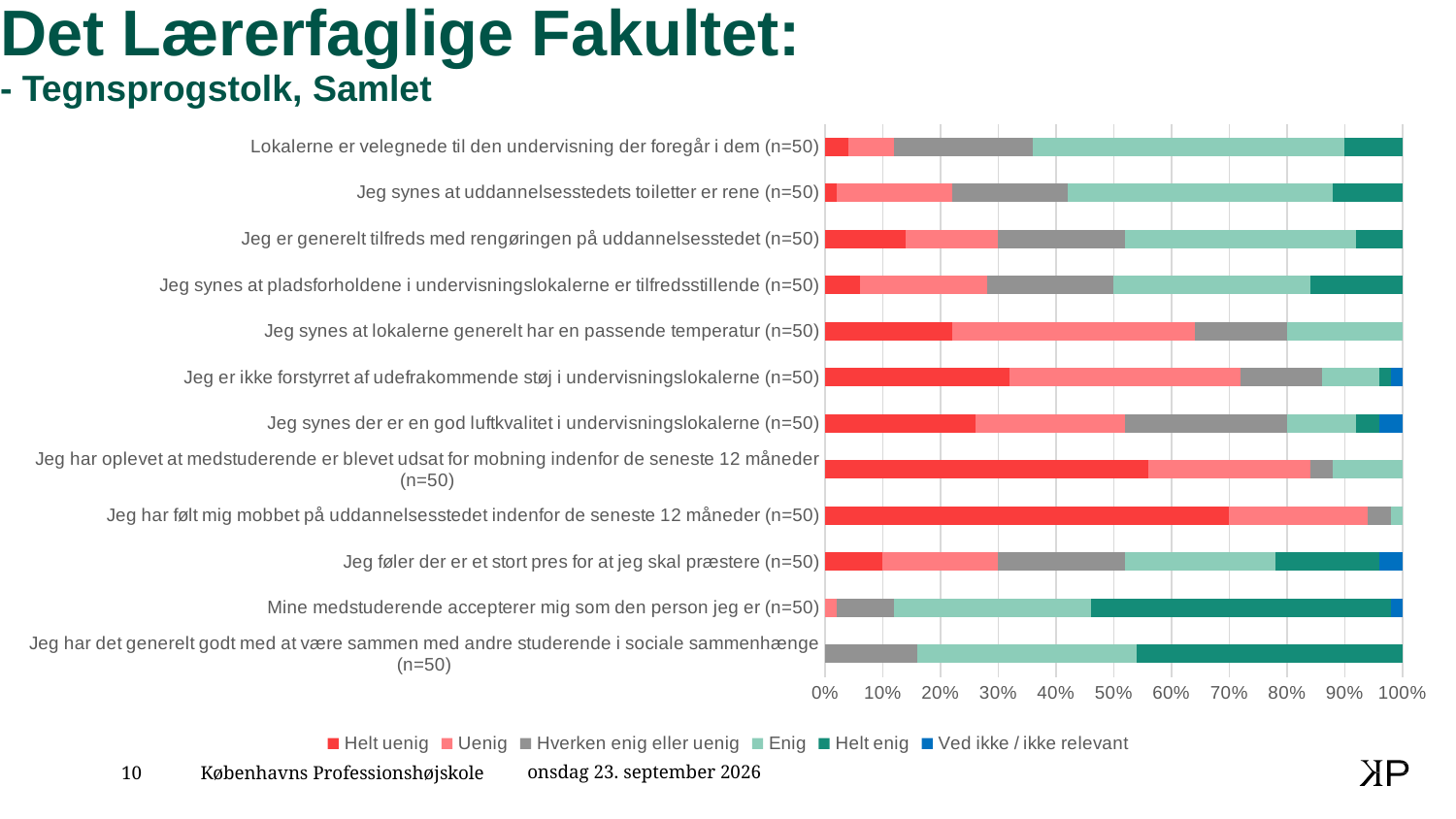
Which statement has the largest 'Helt enig' share? Mine medstuderende accepterer mig som den person jeg er (n=50) What kind of chart is shown on the slide? Stacked bar chart What is the subtitle of the chart slide, shown under 'Det Lærerfaglige Fakultet:'? - Tegnsprogstolk, Samlet Is the 'Helt uenig' share for 'Jeg har oplevet at medstuderende er blevet udsat for mobning indenfor de seneste 12 måneder' greater or less than 50%? greater Is the 'Helt uenig' share for 'Jeg synes at lokalerne generelt har en passende temperatur' greater or less than 30%? less Which has the larger 'Helt uenig' share: 'Jeg føler der er et stort pres for at jeg skal præstere' or 'Jeg synes der er en god luftkvalitet i undervisningslokalerne'? Jeg synes der er en god luftkvalitet i undervisningslokalerne Is the 'Helt enig' share for 'Jeg har det generelt godt med at være sammen med andre studerende i sociale sammenhænge' greater or less than 40%? greater What is the first entry in the chart legend? Helt uenig Which statement has the largest 'Helt uenig' share? Jeg har følt mig mobbet på uddannelsesstedet indenfor de seneste 12 måneder (n=50) How many series does the chart legend list? 6 How many statements (categories) are plotted in the chart? 12